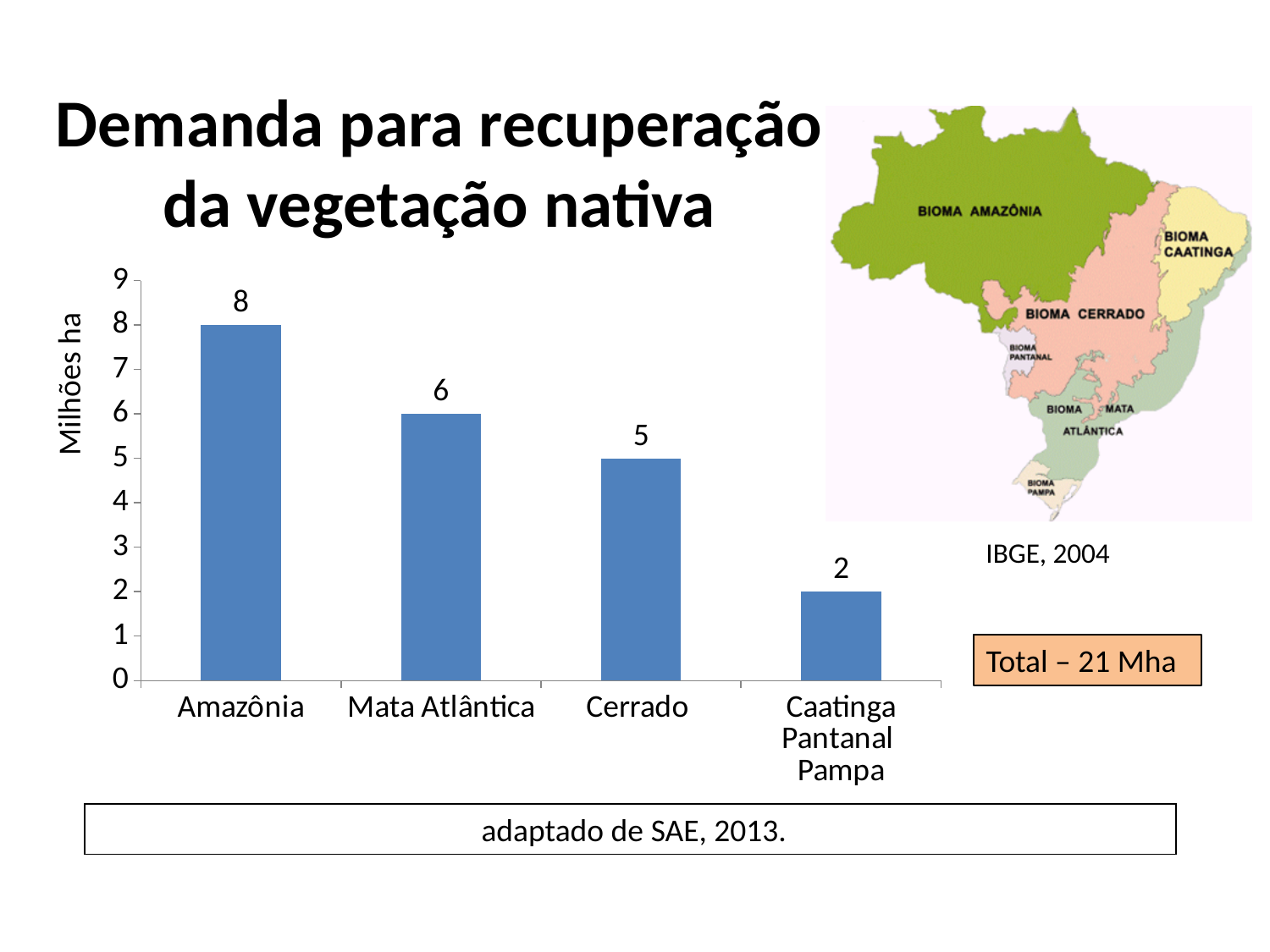
What is the value for Cerrado? 5 What is the difference between the values for Amazônia and Cerrado? 3 What is the value for Mata Atlântica? 6 How many categories are shown on the x axis? 4 What kind of chart is shown? bar chart What is the value for Amazônia? 8 What is the label of the y axis? Milhões ha Do the values rise or fall from left to right along the x axis? fall Which is larger, the value for Mata Atlântica or the value for Cerrado? Mata Atlântica Which category has the lowest value? Caatinga Pantanal Pampa What is the value for Caatinga Pantanal Pampa? 2 Which category has the highest value? Amazônia